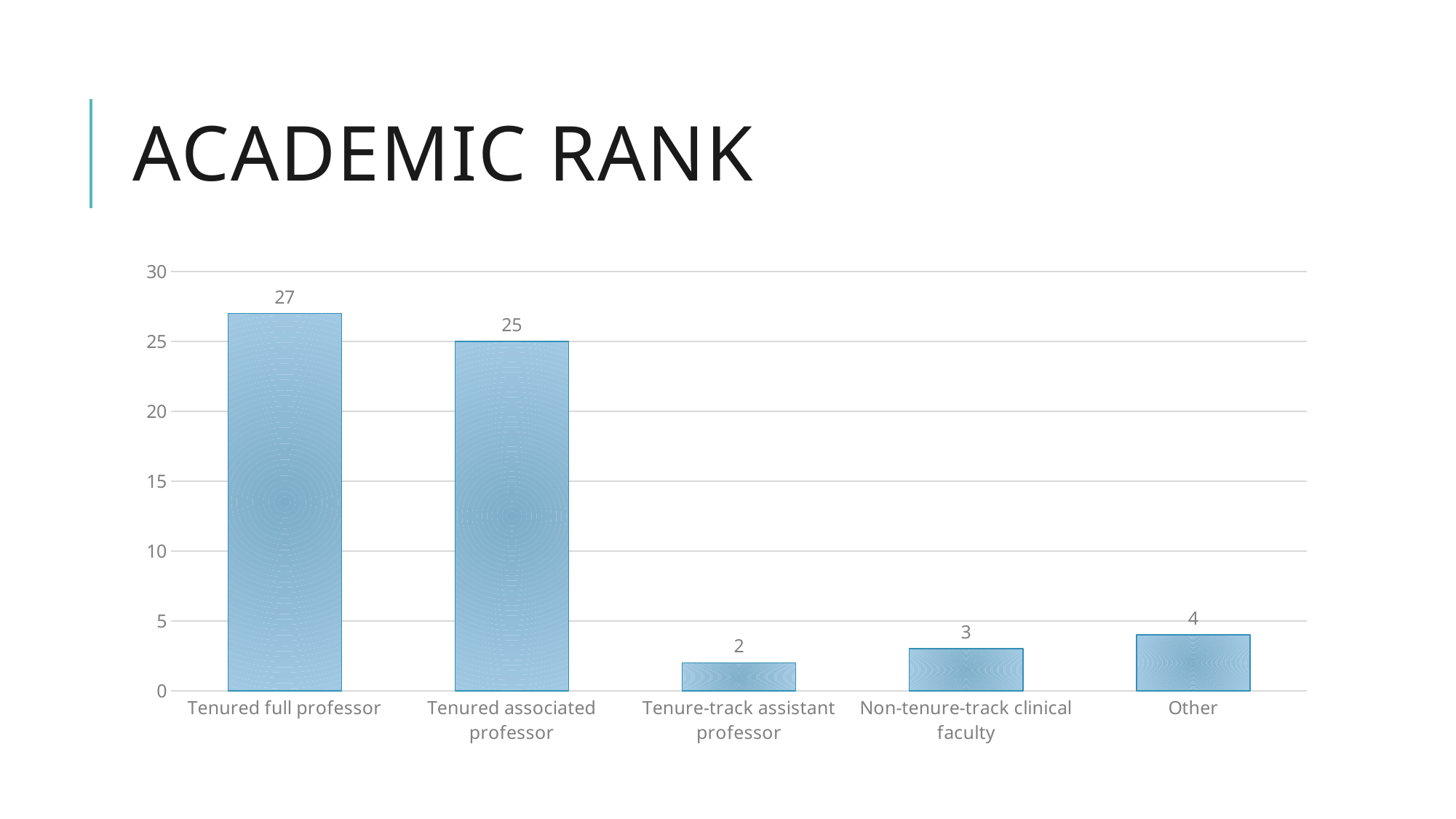
What is the value for Tenure-track assistant professor? 2 How many categories are shown on the chart? 5 What is the title of the slide? ACADEMIC RANK What is the difference between the values for Tenured full professor and Tenured associated professor? 2 What is the value for Tenured full professor? 27 What kind of chart is shown on the slide? Bar chart What is the value for Non-tenure-track clinical faculty? 3 Which category has the lowest value? Tenure-track assistant professor What is the value for Other? 4 Which category has the highest value? Tenured full professor Which is larger, the value for Other or the value for Non-tenure-track clinical faculty? Other What is the value for Tenured associated professor? 25